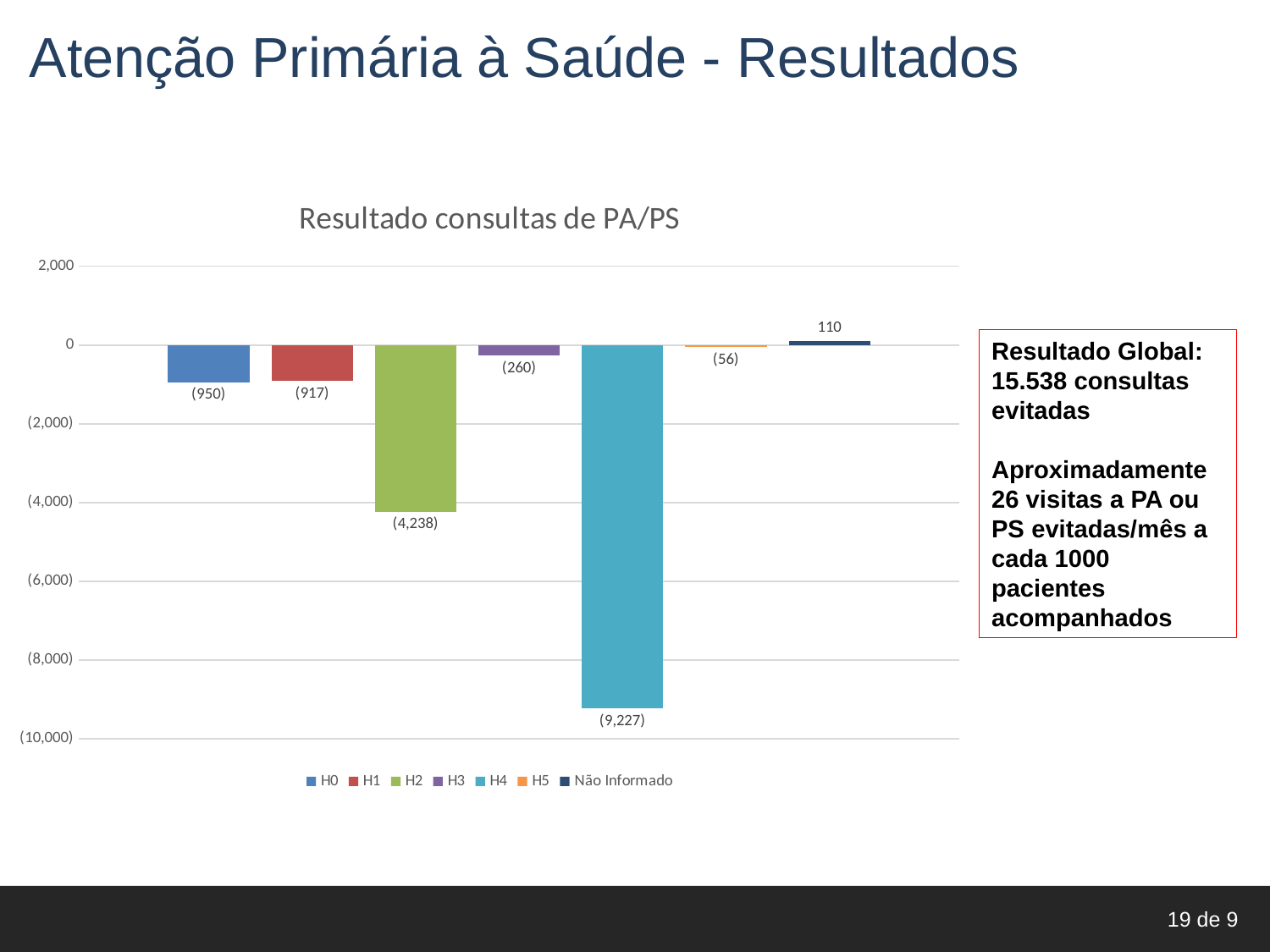
Which has the larger magnitude of consultas evitadas, H2 or H3? H2 What is the value shown for H0 in the chart? (950) What is the difference between the values for H0 and H1? 33 Which category has the lowest value in the chart? H4 What is the value shown for H4 in the chart? (9,227) How many bars are plotted in the chart? 7 What is the value shown for Não Informado in the chart? 110 What is the value shown for H2 in the chart? (4,238) Is the value for H2 greater or less than (4,000)? less What is the title of the chart? Resultado consultas de PA/PS What kind of chart is shown on the slide? Bar chart Which category has the highest value in the chart? Não Informado